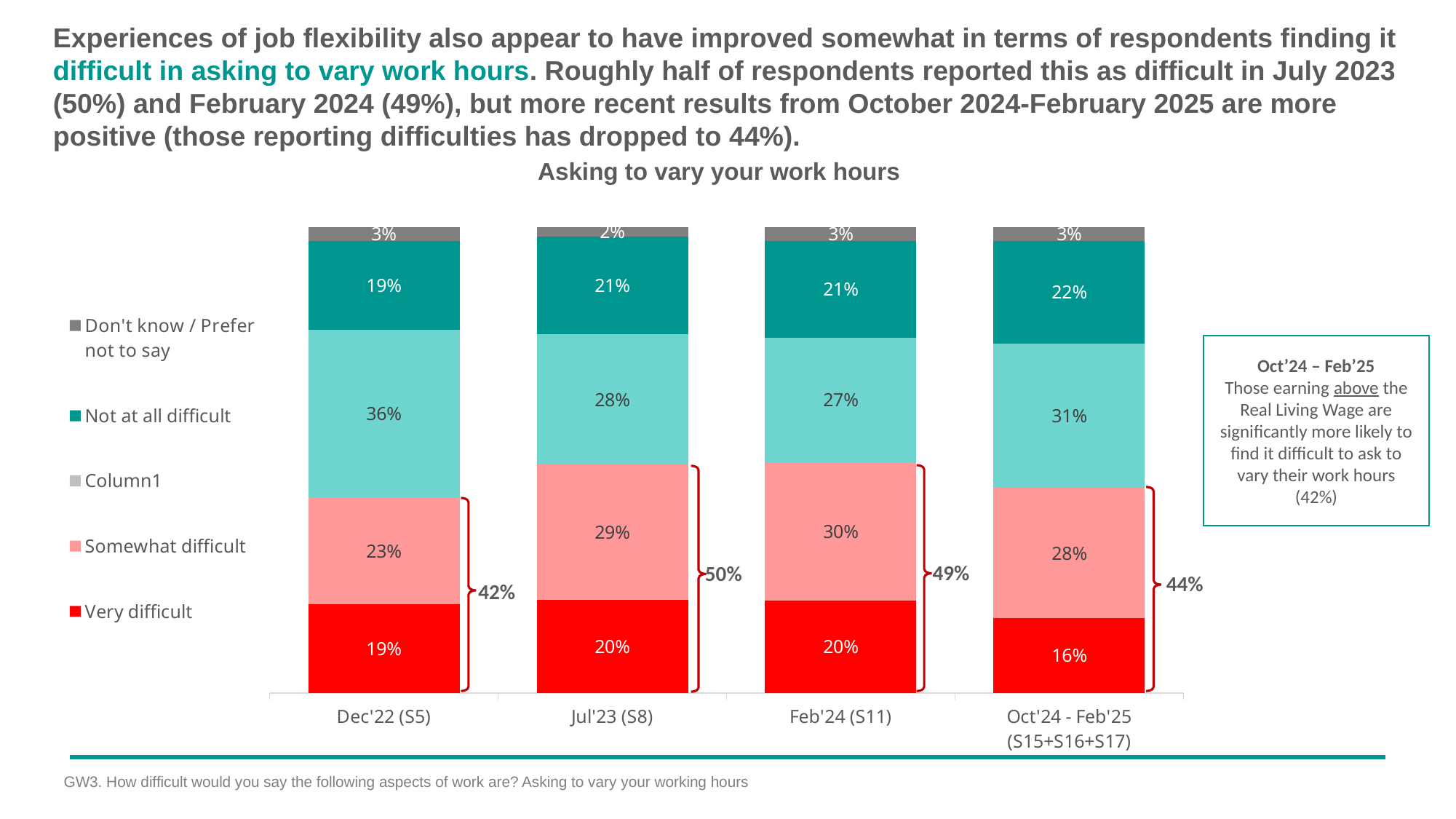
What is the difference between the 'Somewhat difficult' values for Jul'23 (S8) and Dec'22 (S5)? 6% What is the 'Don't know / Prefer not to say' value for Jul'23 (S8)? 2% Which time period has the highest 'Not at all difficult' percentage? Oct'24 - Feb'25 (S15+S16+S17) What is the title of the chart? Asking to vary your work hours What is the combined 'Very difficult' and 'Somewhat difficult' share shown by the bracket for Feb'24 (S11)? 49% What type of chart is shown on the slide? Stacked bar chart What percentage of respondents said 'Not at all difficult' in Oct'24 - Feb'25 (S15+S16+S17)? 22% What percentage of respondents said 'Very difficult' in Dec'22 (S5)? 19% Which time period has the lowest 'Very difficult' percentage? Oct'24 - Feb'25 (S15+S16+S17) What percentage of respondents said 'Somewhat difficult' in Feb'24 (S11)? 30% How many series does the legend list? 5 How many time periods (bars) are shown on the x axis? 4